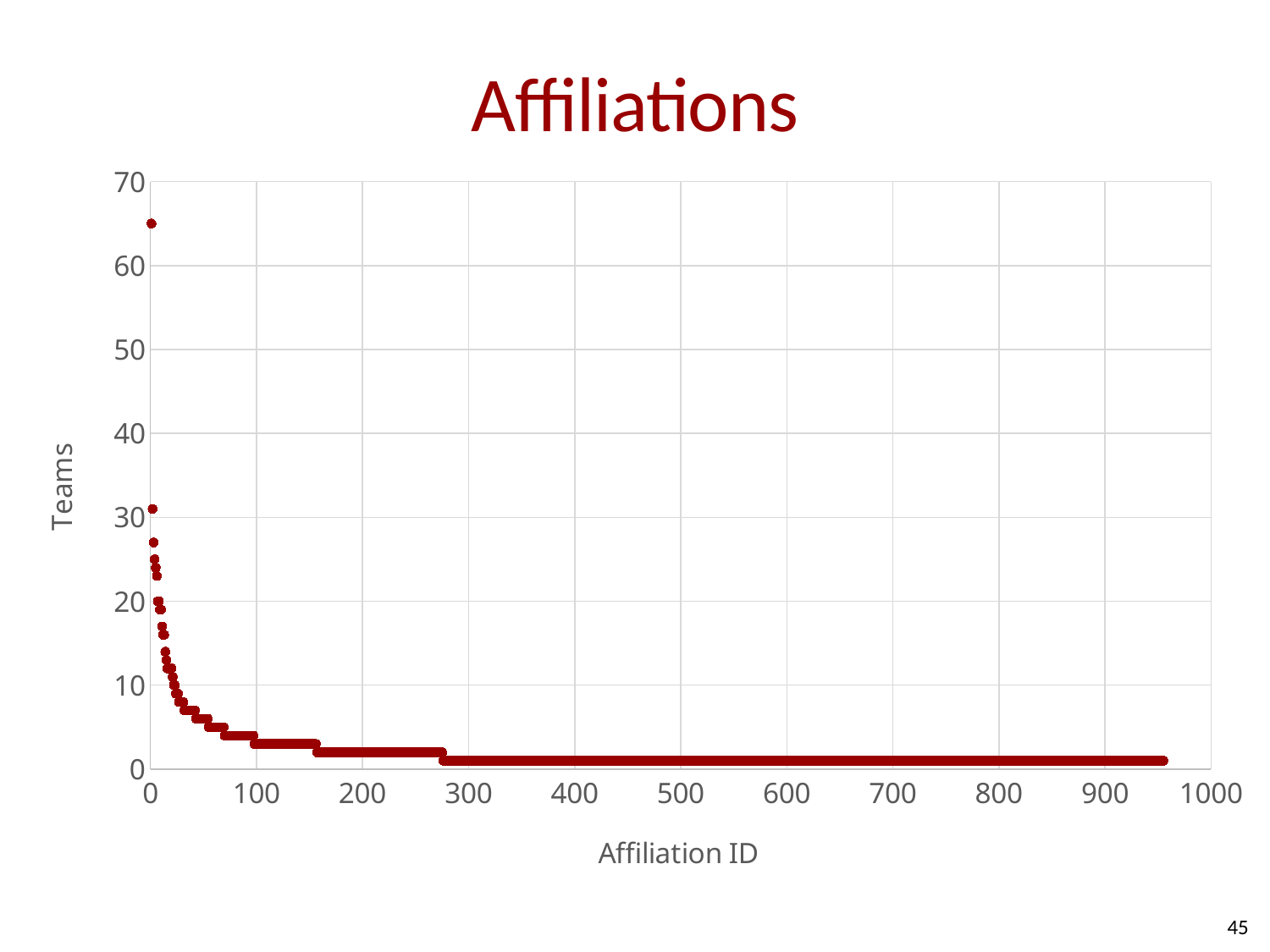
Is the Teams value at Affiliation ID 500 greater or less than 10? less Is the Teams value for the second-highest point on the chart greater or less than 40? less Is the Teams value for the highest point on the chart greater or less than 70? less What kind of chart is shown on the slide? scatter chart Which has the larger Teams value: the point at Affiliation ID 1 or the point at Affiliation ID 500? Affiliation ID 1 What is the title of the chart? Affiliations Do the Teams values rise or fall as Affiliation ID increases along the x axis? fall What is the label of the x axis? Affiliation ID